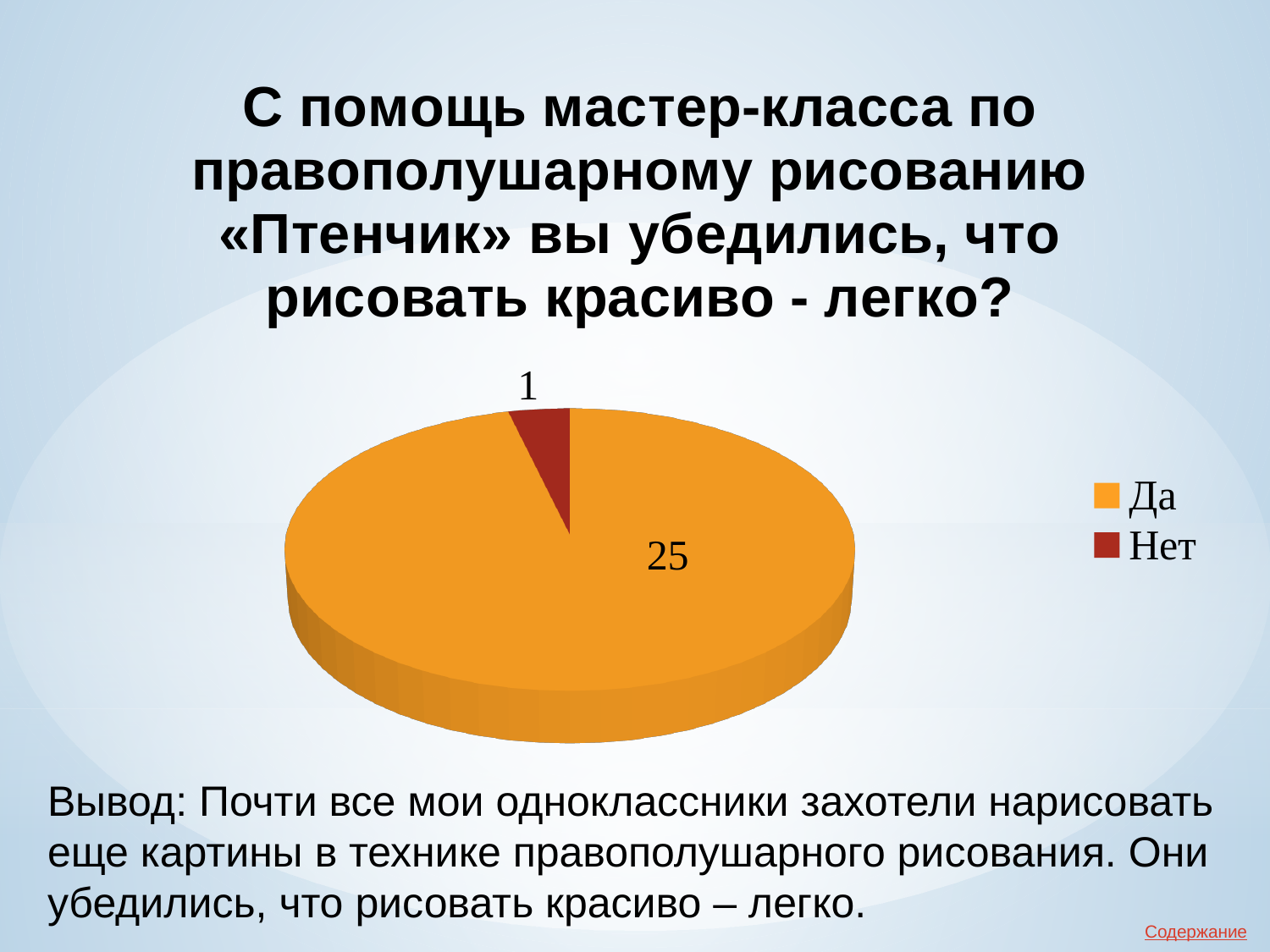
What is the value for «Нет»? 1 How many categories does the pie chart have? 2 Which category has the smallest slice? Нет How many entries does the legend list? 2 Which category has the largest slice? Да What is the total of all slices in the pie chart? 26 What is the difference between the values for «Да» and «Нет»? 24 What colour is the «Нет» slice? dark red Which is larger, the value for «Да» or the value for «Нет»? Да What colour is the «Да» slice? orange What kind of chart is shown on the slide? pie chart What is the value for «Да»? 25